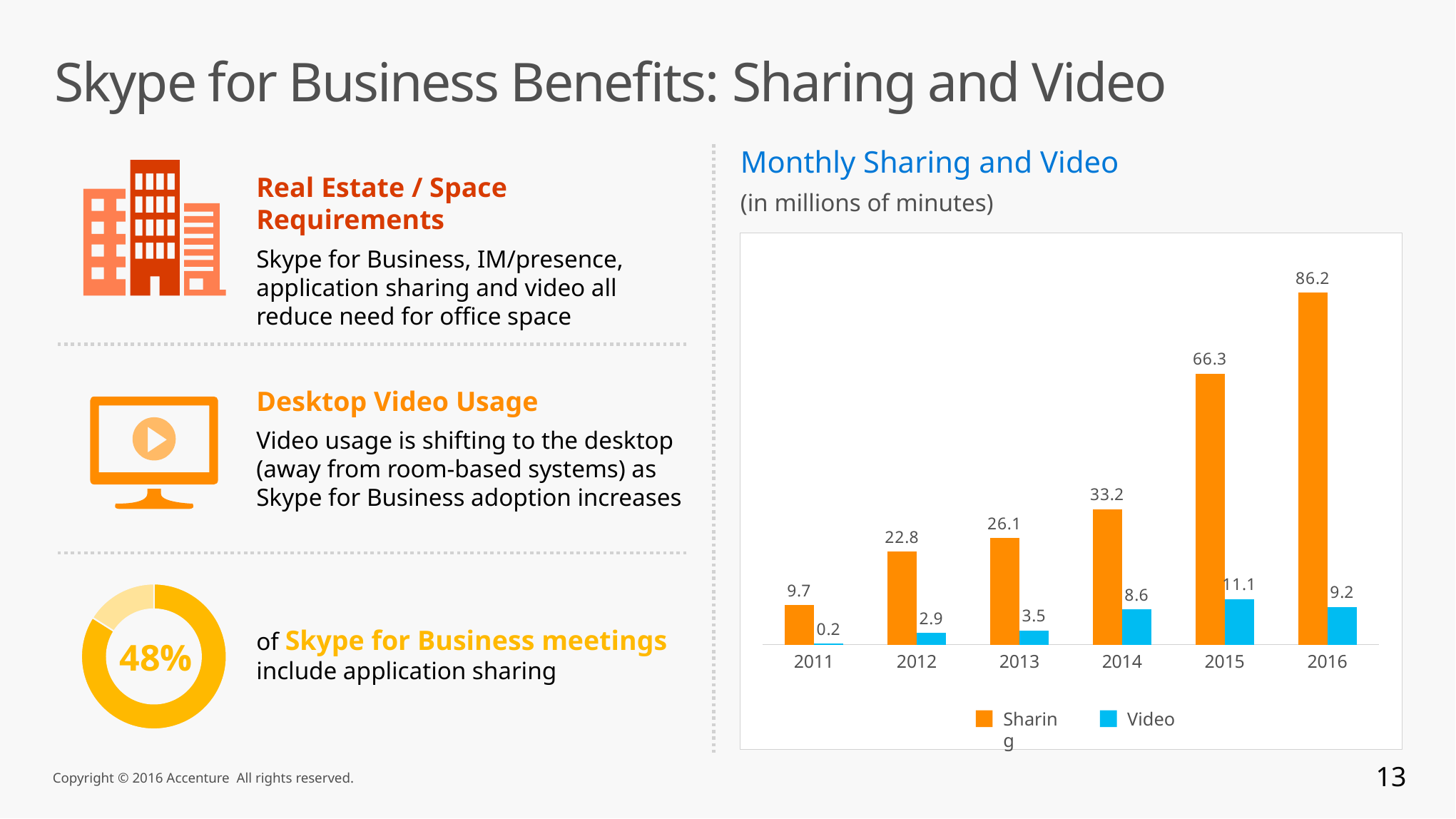
How many series does the legend of the Monthly Sharing and Video chart list? 2 In the Monthly Sharing and Video chart, is the Video value for 2015 larger or smaller than the Video value for 2016? larger Which year has the lowest Video value in the Monthly Sharing and Video chart? 2011 What is the Video value for 2014 in the Monthly Sharing and Video chart? 8.6 What is the difference between the Sharing values for 2016 and 2015 in the Monthly Sharing and Video chart? 19.9 Which year has the highest Sharing value in the Monthly Sharing and Video chart? 2016 Which year has the highest Video value in the Monthly Sharing and Video chart? 2015 What is the Video value for 2011 in the Monthly Sharing and Video chart? 0.2 What is the Sharing value for 2016 in the Monthly Sharing and Video chart? 86.2 What kind of chart is the Monthly Sharing and Video chart? bar chart Do the Sharing values rise or fall from 2011 to 2016 in the Monthly Sharing and Video chart? rise How many years are shown on the x axis of the Monthly Sharing and Video chart? 6